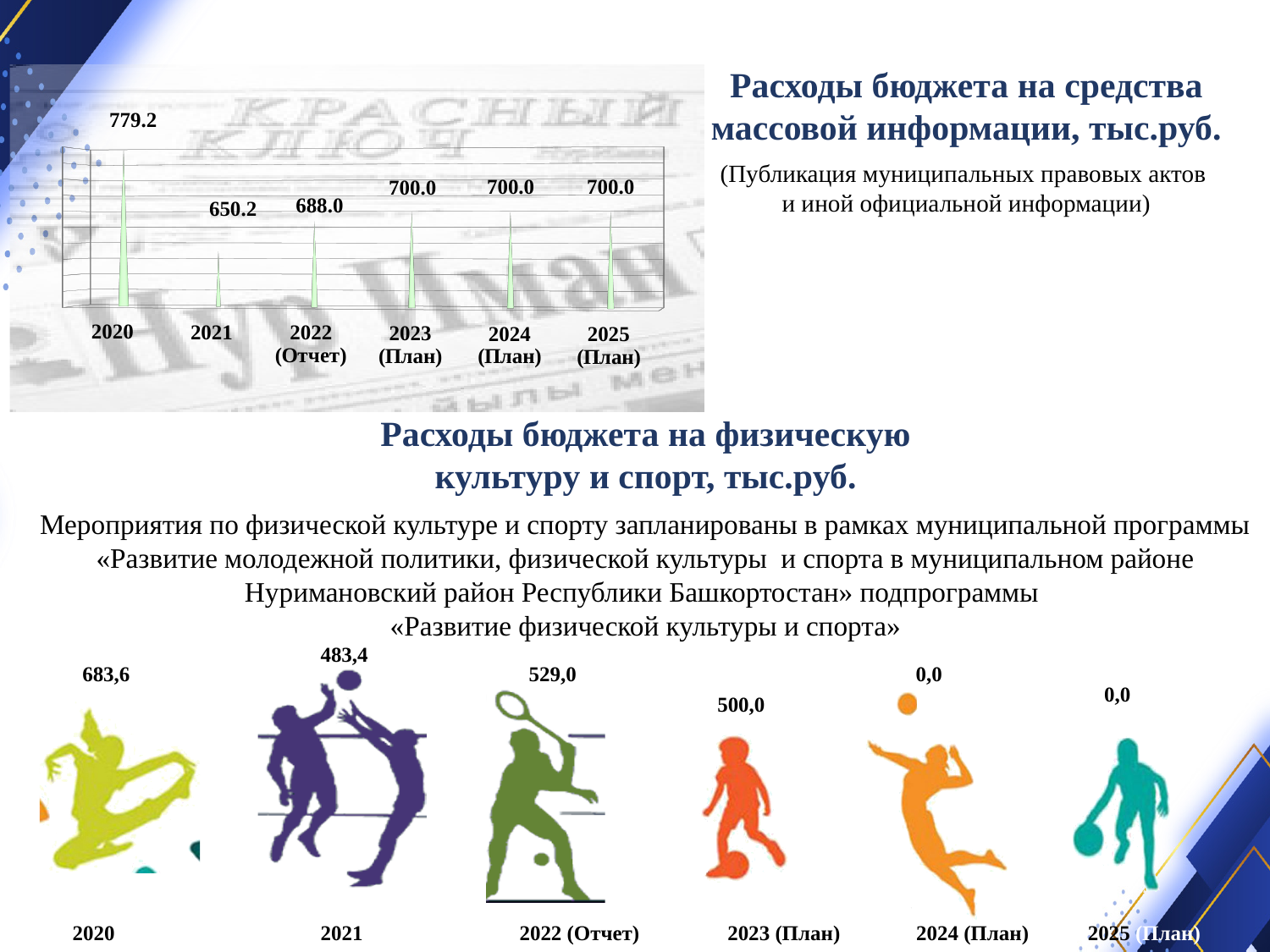
What kind of chart is 'Расходы бюджета на средства массовой информации, тыс.руб.'? bar chart In the chart 'Расходы бюджета на средства массовой информации, тыс.руб.', which is larger: the value for 2022 (Отчет) or for 2023 (План)? 2023 (План) In the chart 'Расходы бюджета на средства массовой информации, тыс.руб.', what is the difference between the values for 2020 and 2021? 129.0 In the infographic 'Расходы бюджета на физическую культуру и спорт, тыс.руб.', what is the value for 2022 (Отчет)? 529,0 In the chart 'Расходы бюджета на средства массовой информации, тыс.руб.', which year has the highest value? 2020 In the infographic 'Расходы бюджета на физическую культуру и спорт, тыс.руб.', what is the value for 2020? 683,6 In the chart 'Расходы бюджета на средства массовой информации, тыс.руб.', what is the value for 2021? 650.2 In the chart 'Расходы бюджета на средства массовой информации, тыс.руб.', do the values rise, fall or stay the same from 2023 (План) to 2025 (План)? stay the same In the chart 'Расходы бюджета на средства массовой информации, тыс.руб.', what is the value for 2022 (Отчет)? 688.0 In the chart 'Расходы бюджета на средства массовой информации, тыс.руб.', what is the value for 2020? 779.2 How many years are shown in the chart 'Расходы бюджета на средства массовой информации, тыс.руб.'? 6 In the chart 'Расходы бюджета на средства массовой информации, тыс.руб.', which year has the lowest value? 2021